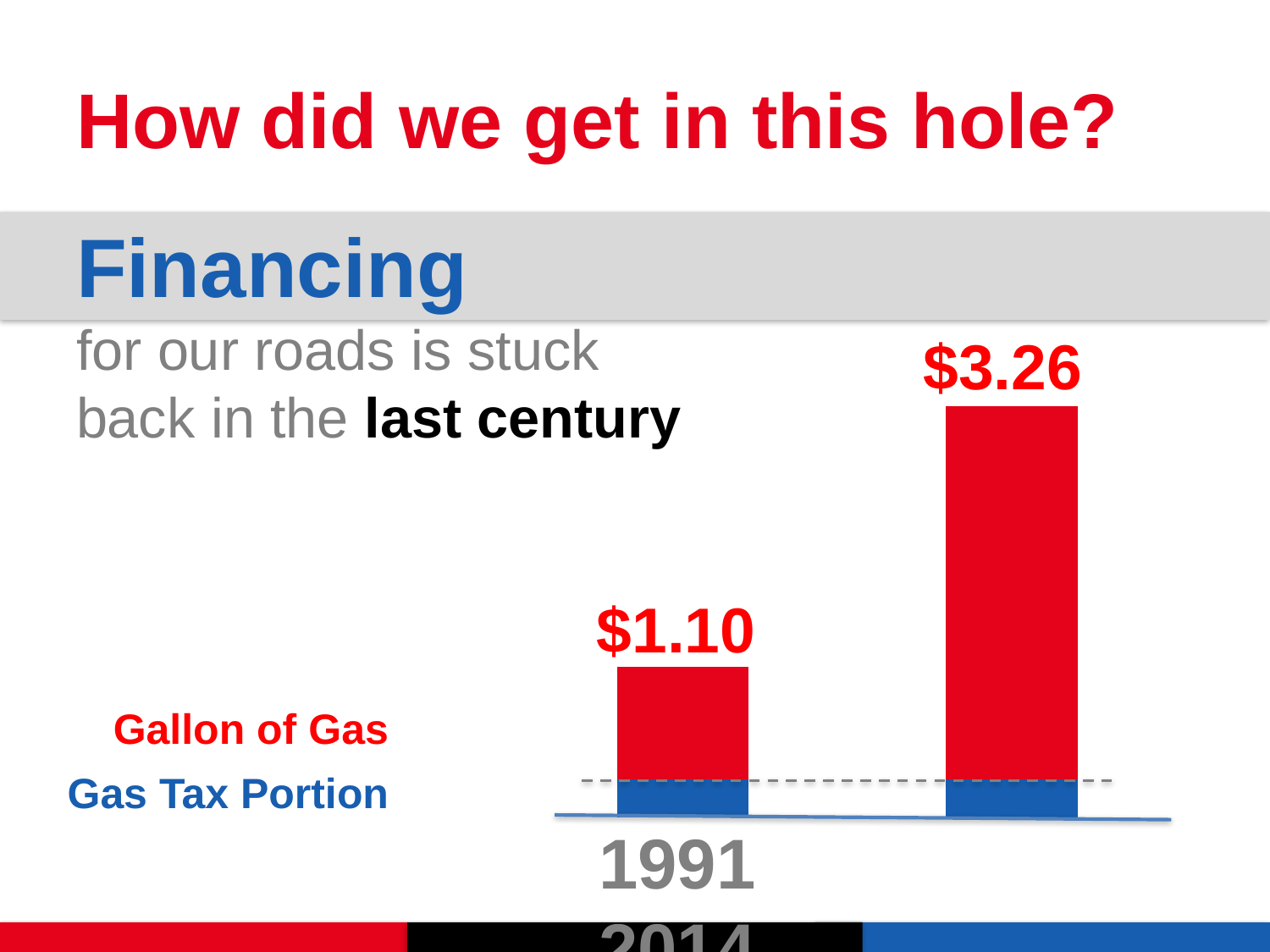
What kind of chart is shown on the slide? bar chart How many bars are plotted in the chart? 2 Is the value for 1991 greater or less than $3.26? less What does the red portion of each bar represent? Gallon of Gas What is the difference between the two labelled values, $3.26 and $1.10? $2.16 Do the labelled values rise or fall from the left bar to the right bar? rise Which bar is taller, the 1991 bar or the right-hand bar? the right-hand bar Which colour represents the Gas Tax Portion in the chart? blue What is the value shown above the right-hand (taller) bar? $3.26 What is the value shown above the bar for 1991? $1.10